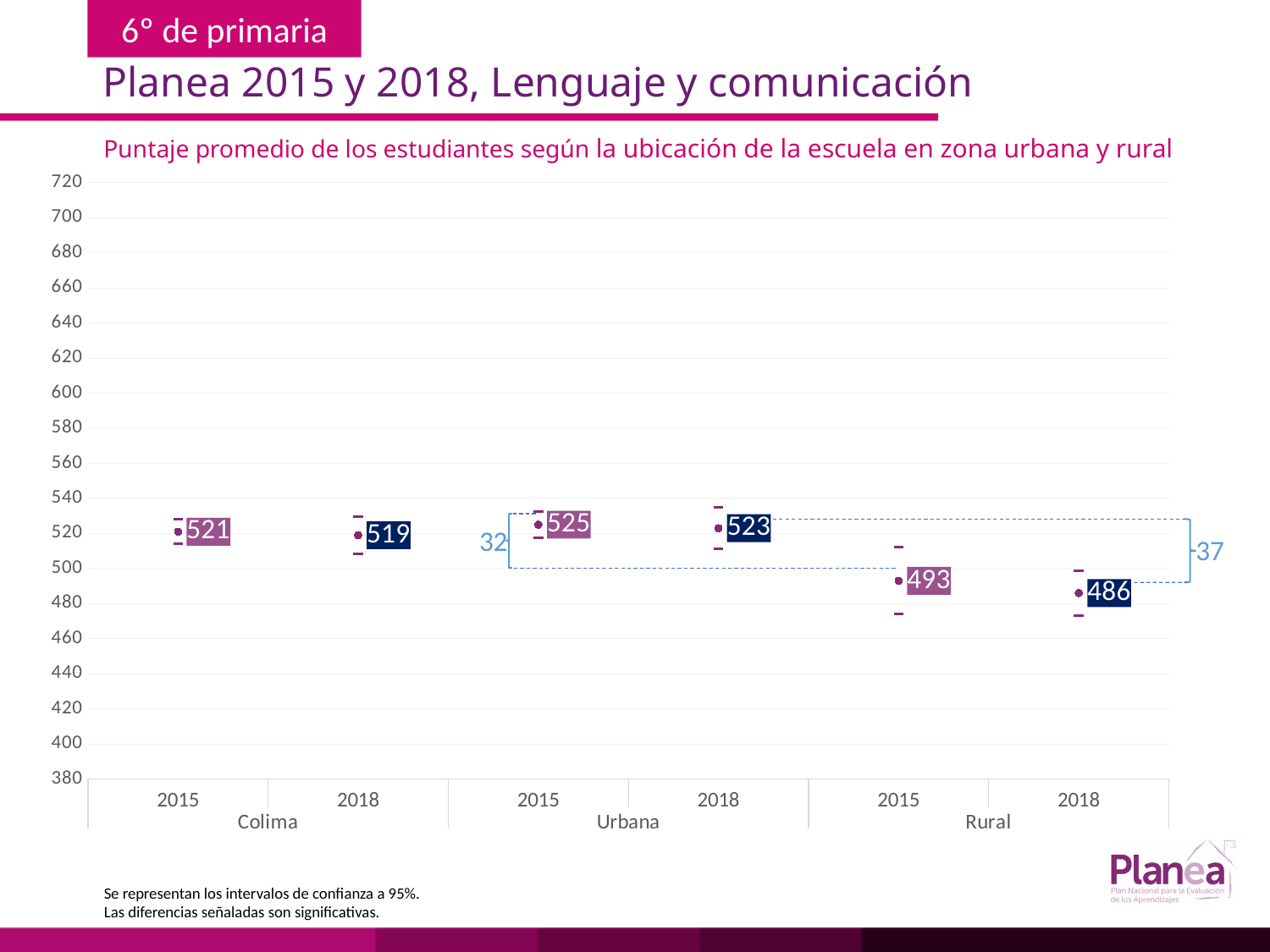
How many data points are plotted on the chart? 6 What is the difference between the Urbana and Rural scores in 2018? 37 Which is larger, the Rural score in 2015 or the Rural score in 2018? Rural 2015 What is the average score for Urbana schools in 2015? 525 What is the average score for Colima in 2015? 521 Did the Rural score rise or fall from 2015 to 2018? fall Which group and year has the lowest average score? Rural 2018 Is the Rural 2015 score greater or less than 500? less What is the difference between the Urbana and Rural scores in 2015? 32 What is the average score for Rural schools in 2018? 486 Which group and year has the highest average score? Urbana 2015 What is the average score for Colima in 2018? 519